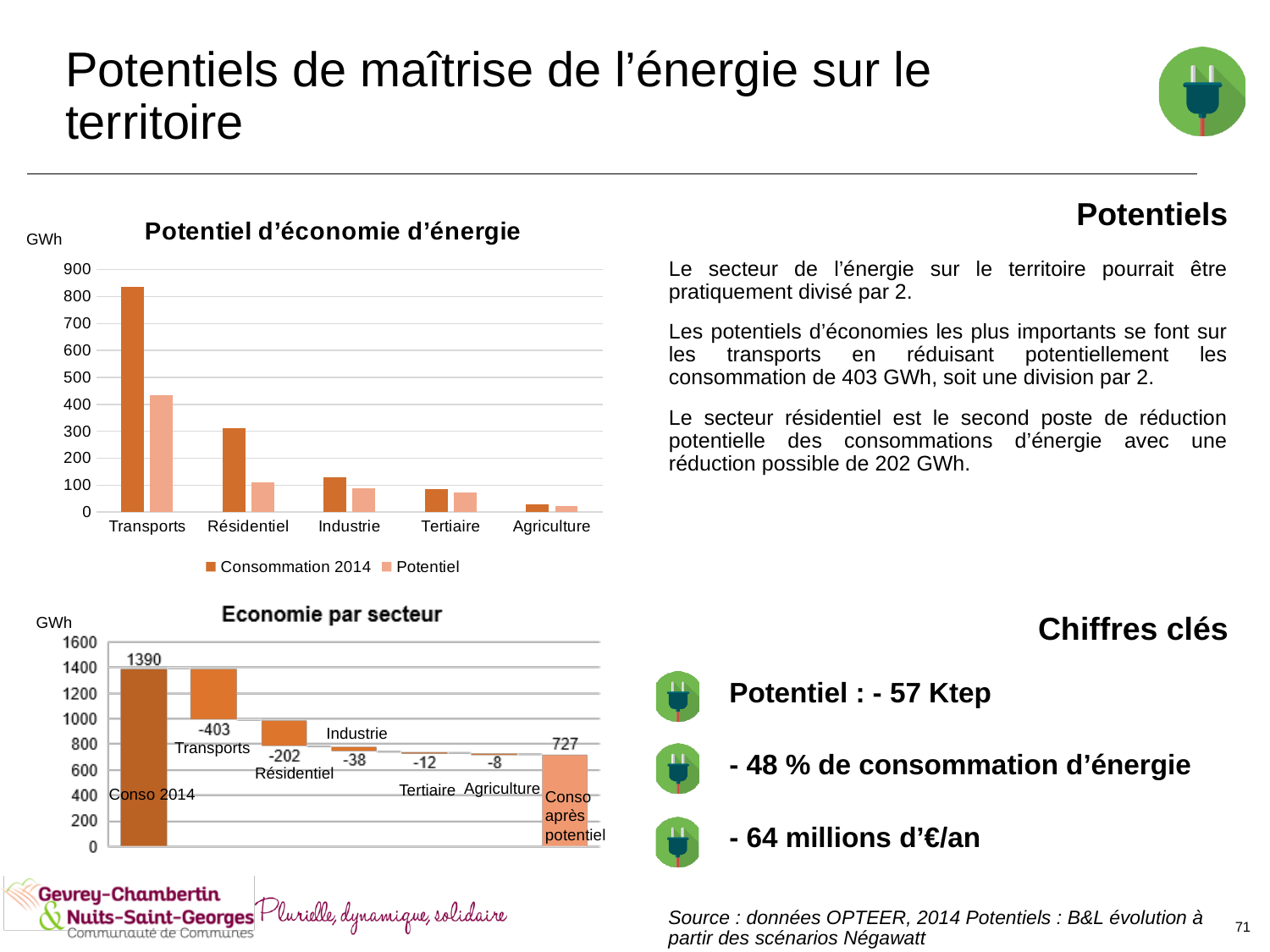
In the 'Potentiel d'économie d'énergie' chart, which is larger for Résidentiel: Consommation 2014 or Potentiel? Consommation 2014 In the 'Potentiel d'économie d'énergie' chart, is the Consommation 2014 value for Transports greater or less than 800? greater In the 'Economie par secteur' chart, what is the value shown for Transports? -403 In the 'Potentiel d'économie d'énergie' chart, is the Potentiel value for Transports greater or less than 400? greater What type of chart is 'Potentiel d'économie d'énergie'? Bar chart In the 'Economie par secteur' chart, what is the value for Conso après potentiel? 727 In the 'Potentiel d'économie d'énergie' chart, how many categories are shown on the x axis? 5 In the 'Economie par secteur' chart, what is the difference between Conso 2014 and Conso après potentiel? 663 In the 'Economie par secteur' chart, what is the value for Conso 2014? 1390 In the 'Potentiel d'économie d'énergie' chart, which category has the lowest Potentiel value? Agriculture In the 'Potentiel d'économie d'énergie' chart, how many series does the legend list? 2 In the 'Potentiel d'économie d'énergie' chart, which category has the highest Consommation 2014 value? Transports